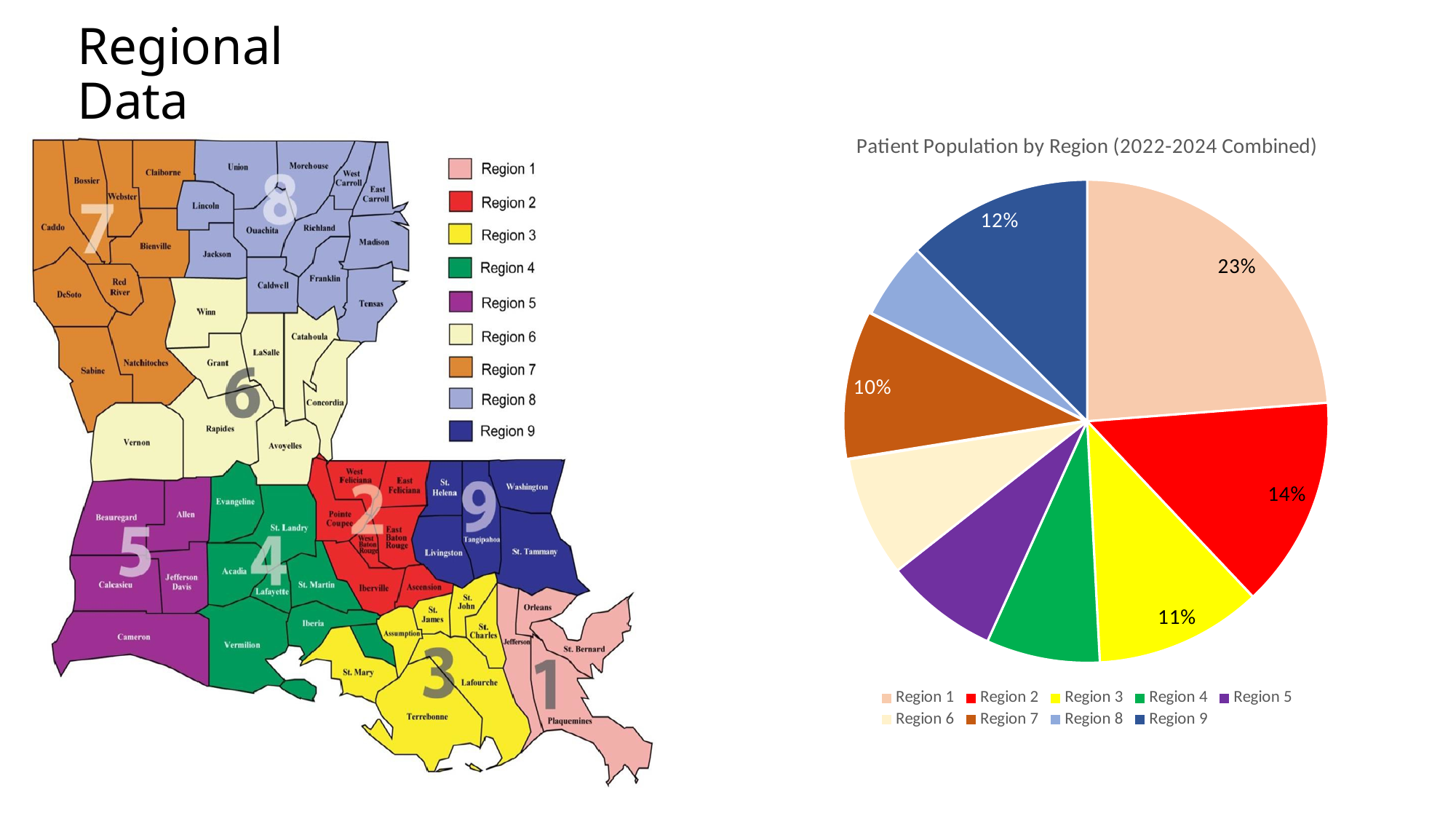
How many regions are shown as slices in the pie chart? 9 What share of the patient population does Region 1 represent? 23% What is the value shown for Region 3? 11% What is the difference between the shares of Region 1 and Region 2? 9% What is the value shown for Region 9? 12% Which region has the largest share of the patient population? Region 1 What is the value shown for Region 2? 14% What is the value shown for Region 7? 10% Which has a larger share, Region 9 or Region 7? Region 9 What type of chart is shown on the slide? pie chart What is the title of the chart? Patient Population by Region (2022-2024 Combined) Which region has the smallest share of the patient population? Region 8